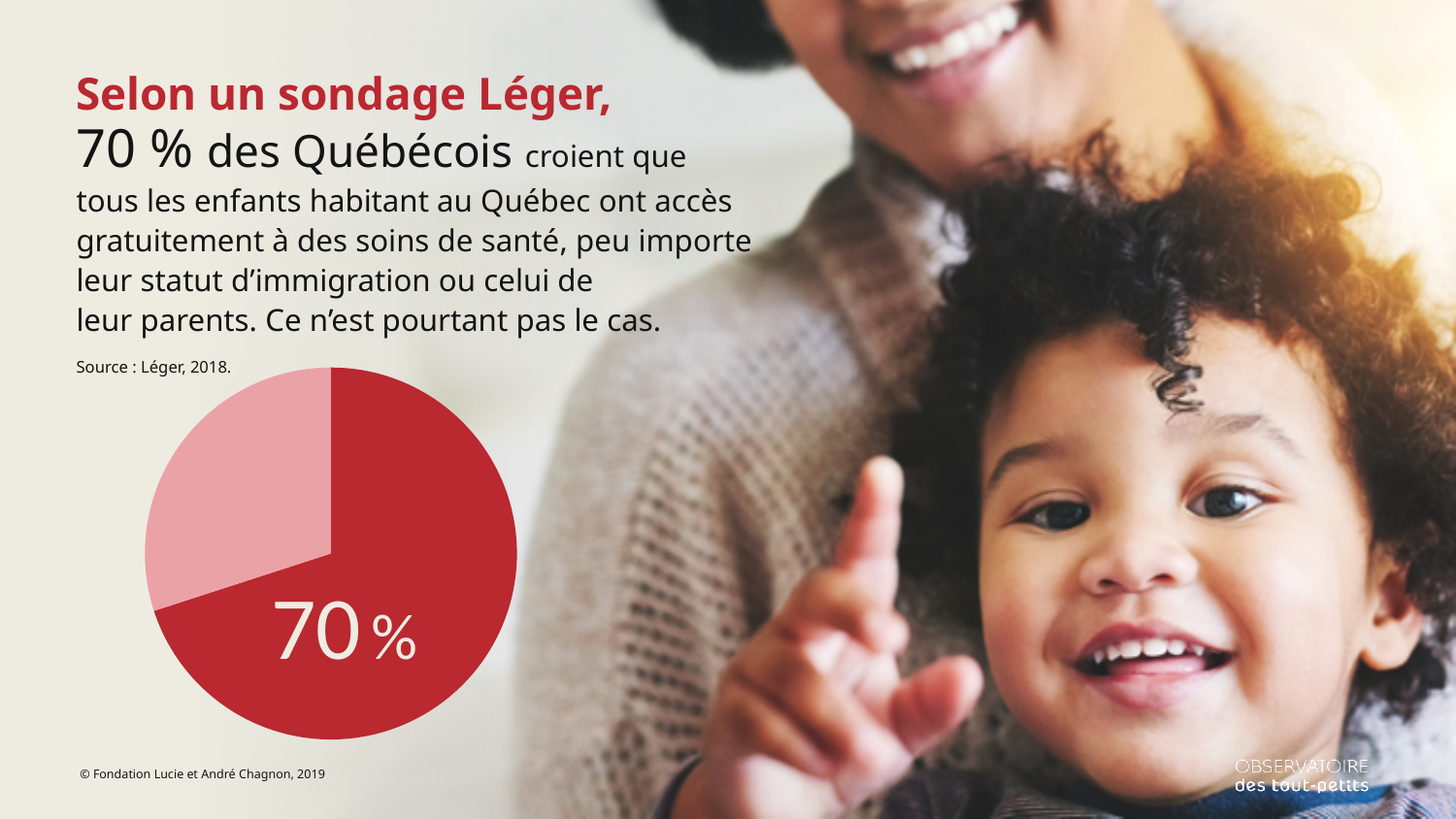
What kind of chart is shown on the slide? pie chart What percentage is printed on the large dark red slice of the pie chart? 70 % Is the labelled slice of the pie chart more or less than half of the pie? more What colour is the slice labelled 70 % in the pie chart? dark red How many slices does the pie chart have? 2 What source is cited for the data shown in the pie chart? Léger, 2018 According to the pie chart, what share of Quebecers believe all children living in Quebec have free access to health care? 70 % Which slice of the pie chart is larger, the dark red one or the light pink one? the dark red one